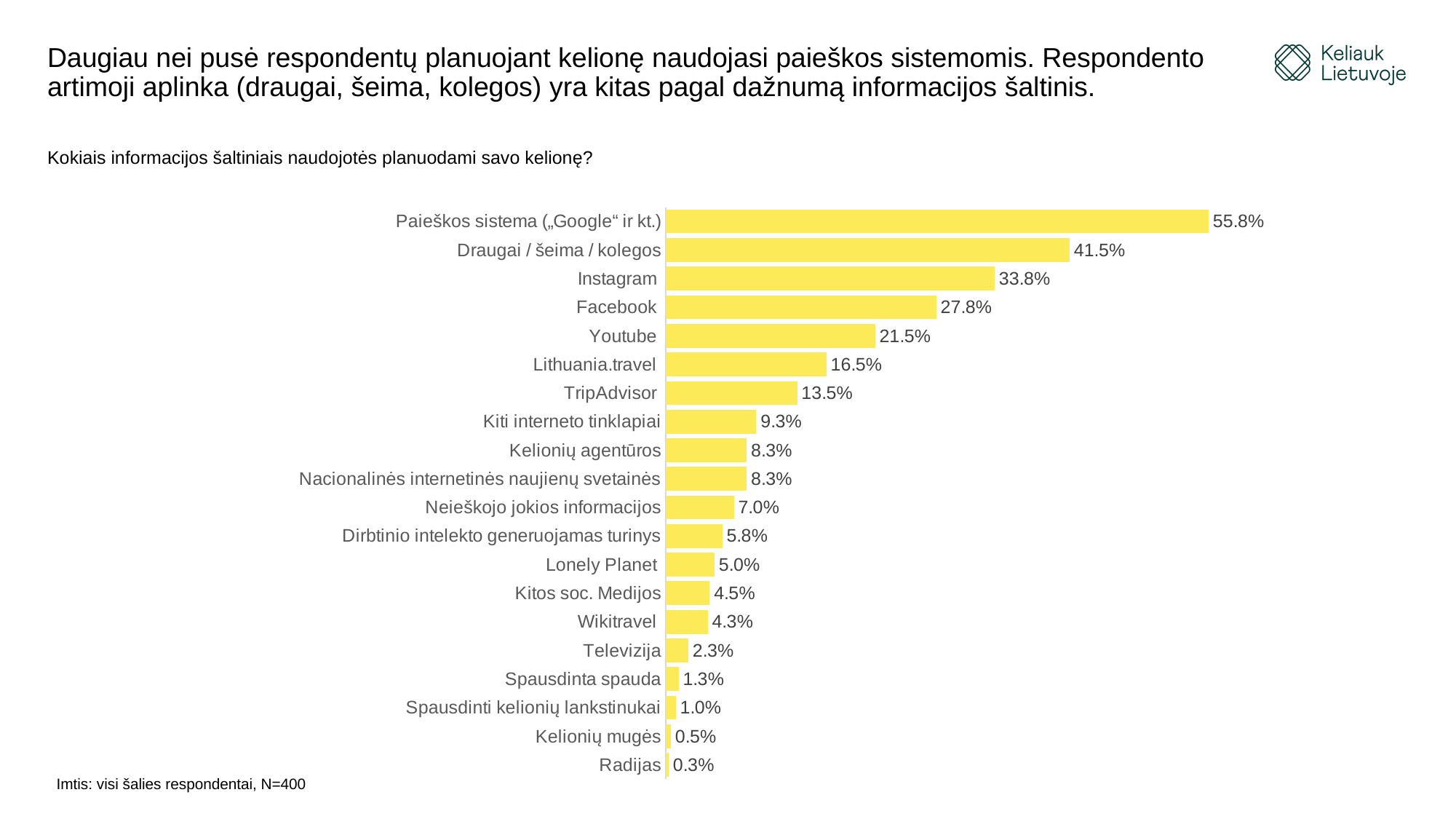
What kind of chart is shown on the slide? Bar chart What is the difference between the values for Paieškos sistema („Google“ ir kt.) and Draugai / šeima / kolegos? 14.3% How many categories are shown in the chart? 20 Which is larger, the value for Televizija or the value for Wikitravel? Wikitravel Which category has the highest value? Paieškos sistema („Google“ ir kt.) What is the difference between the values for Facebook and Youtube? 6.3% What is the value for Instagram? 33.8% What is the sample size stated below the chart? N=400 Which is larger, the value for TripAdvisor or the value for Kiti interneto tinklapiai? TripAdvisor Which category has the lowest value? Radijas What is the value for Lithuania.travel? 16.5% What is the value for Dirbtinio intelekto generuojamas turinys? 5.8%